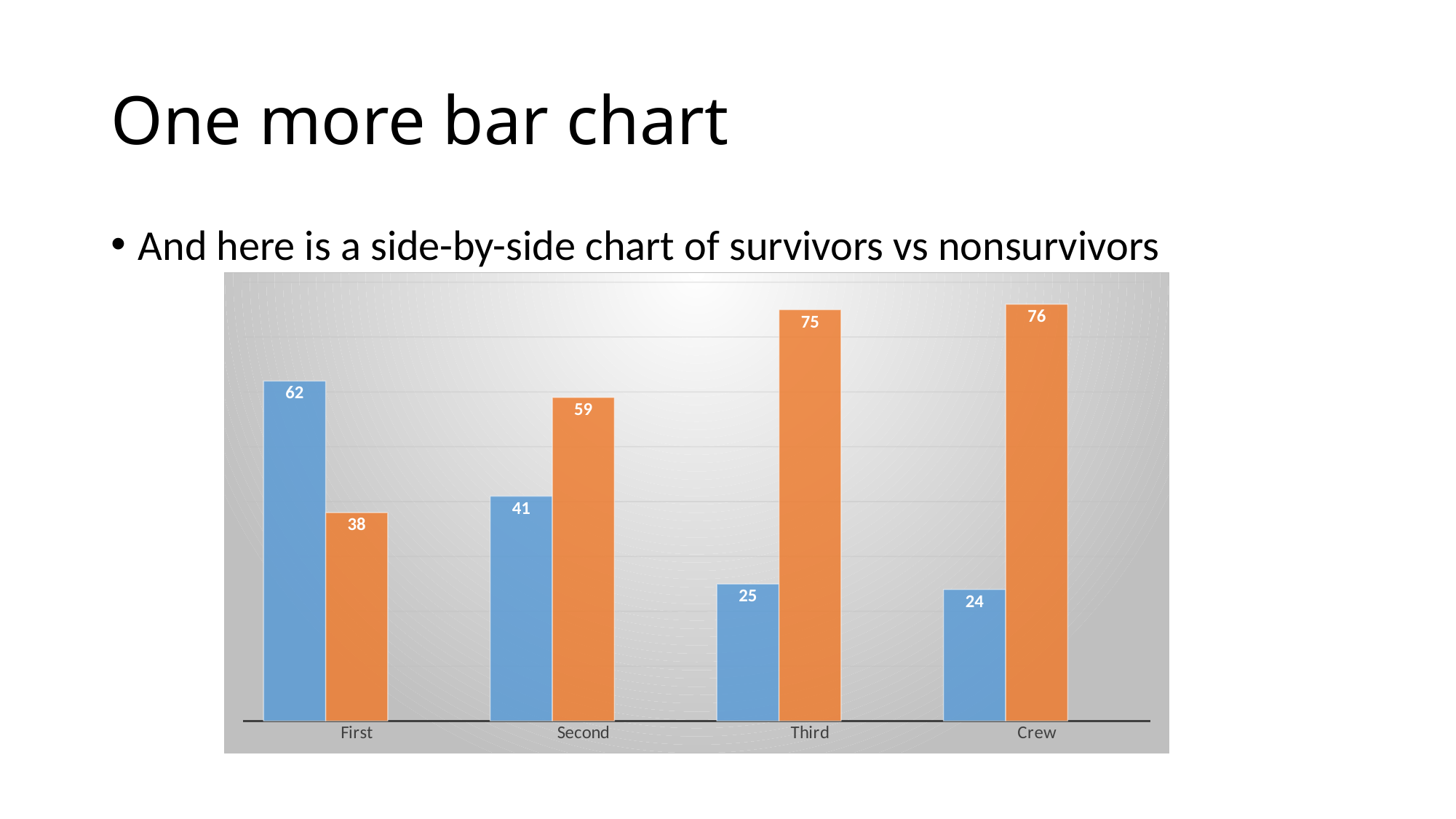
For Second, which bar is larger, blue or orange? orange What is the difference between the blue and orange bars for First? 24 What is the value of the orange bar for Third? 75 What is the value of the orange bar for Second? 59 Which category has the lowest orange bar? First What is the difference between the orange bars for Crew and Second? 17 Which category has the lowest blue bar? Crew What is the value of the blue bar for First? 62 Which category has the highest orange bar? Crew What is the value of the blue bar for Crew? 24 What kind of chart is shown on the slide? bar chart How many categories are shown on the x axis? 4